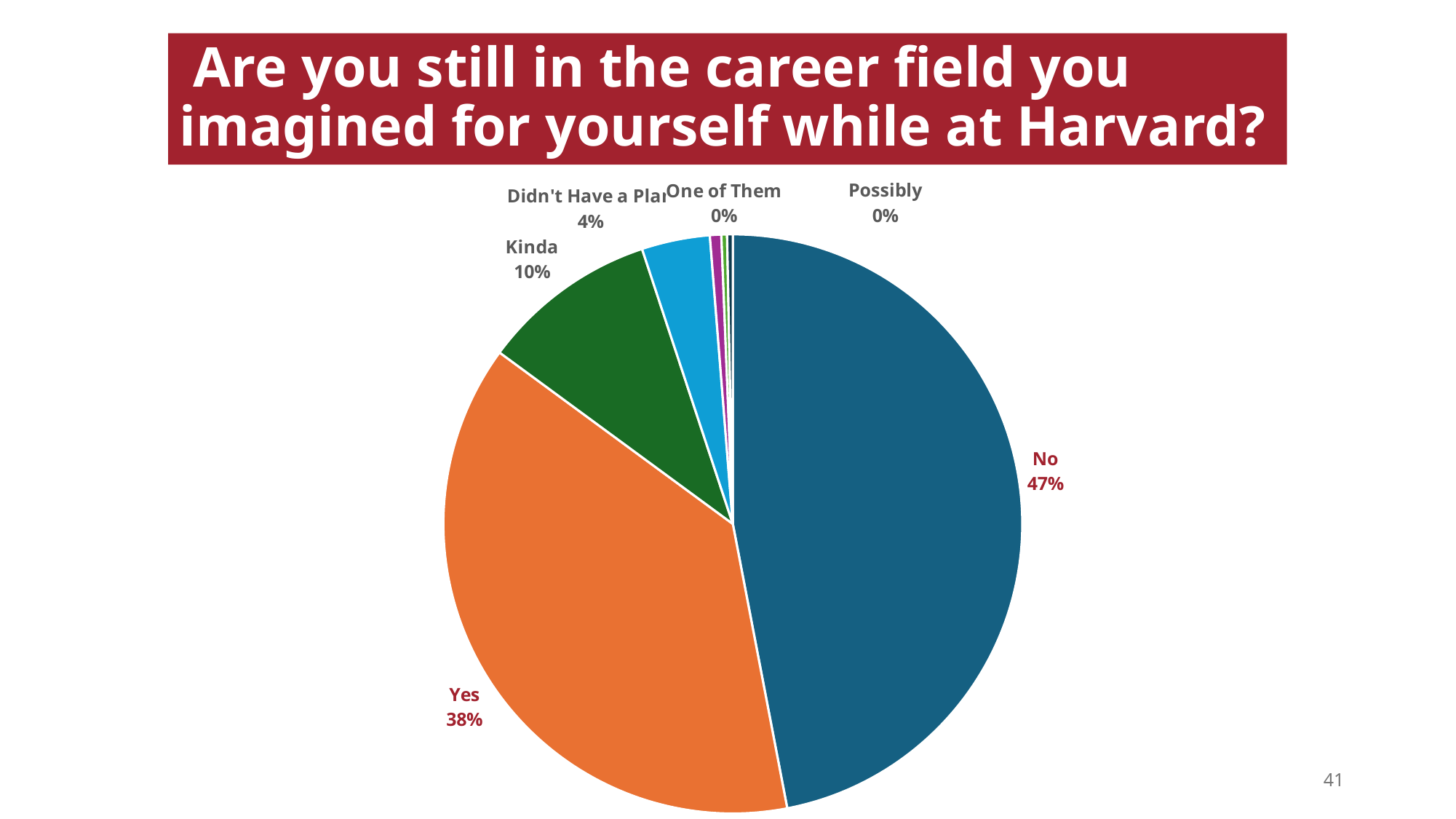
Which slice is larger, "Yes" or "Kinda"? Yes How many percentage points larger is the "Yes" slice than the "Kinda" slice? 28 percentage points What percentage of respondents answered "Yes"? 38% How many response categories are labelled on the pie chart? 6 What kind of chart is shown on the slide? pie chart What percentage is shown for "One of Them"? 0% How many percentage points larger is the "No" slice than the "Yes" slice? 9 percentage points What percentage of respondents answered "No"? 47% What share of the pie is labelled "Kinda"? 10% Which response has the largest slice of the pie? No What percentage is shown for "Possibly"? 0% What question is shown as the title of the slide? Are you still in the career field you imagined for yourself while at Harvard?